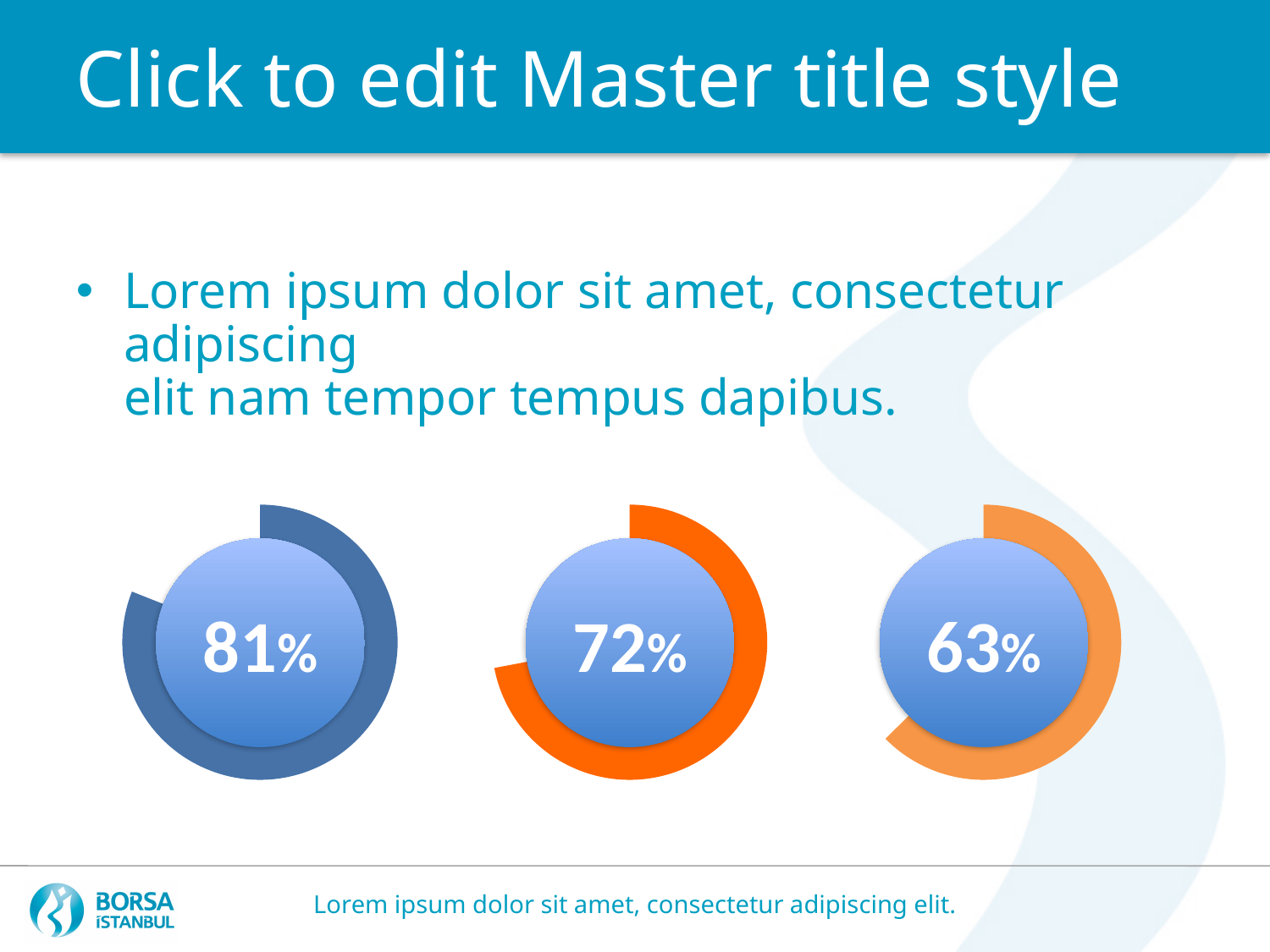
How many circular charts are shown on the slide? 3 What is the difference between the values in the left and middle circular charts? 9% What value is shown in the middle circular chart? 72% What colour is the ring around the left circular chart? Dark blue Do the values rise or fall from the left chart to the right chart? Fall Which of the three circular charts shows the lowest value? The right one (63%) What colour is the ring around the middle circular chart? Orange-red What value is shown in the right circular chart? 63% What is the difference between the values in the left and right circular charts? 18% Which is larger, the value in the middle circular chart or the value in the right circular chart? The middle one (72%) Which of the three circular charts shows the highest value? The left one (81%) What value is shown in the left circular chart? 81%